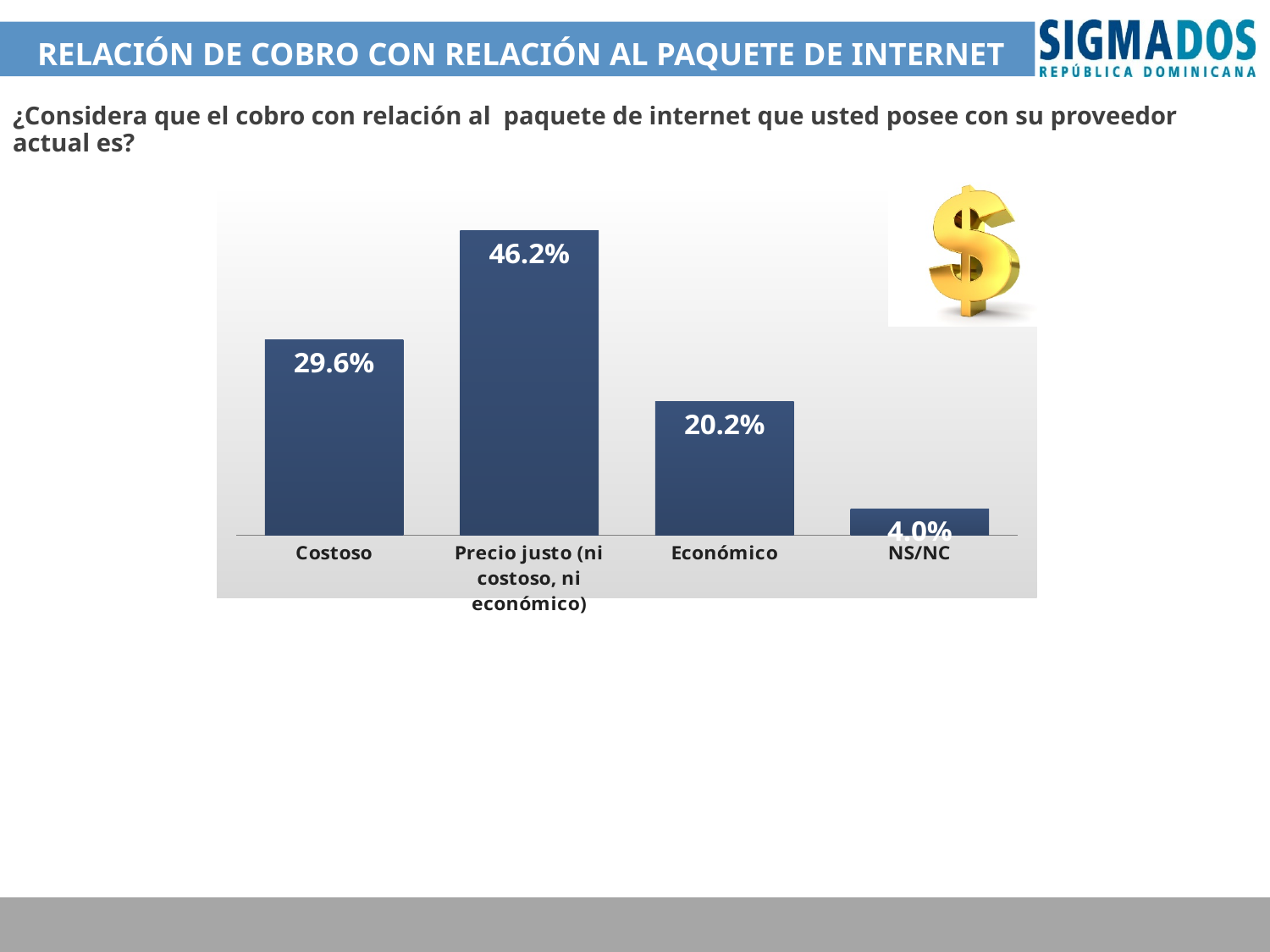
What is the value for Precio justo (ni costoso, ni económico)? 46.2% What is the value for Económico? 20.2% What kind of chart is shown on the slide? Bar chart Which is larger, the value for Costoso or the value for Económico? Costoso Which category has the lowest value? NS/NC What is the difference between the values for Costoso and Económico? 9.4% What is the difference between the values for Precio justo (ni costoso, ni económico) and Costoso? 16.6% What is the title shown in the header bar of the slide? RELACIÓN DE COBRO CON RELACIÓN AL PAQUETE DE INTERNET What is the value for NS/NC? 4.0% What is the value for Costoso? 29.6% How many categories are shown in the chart? 4 Which category has the highest value? Precio justo (ni costoso, ni económico)